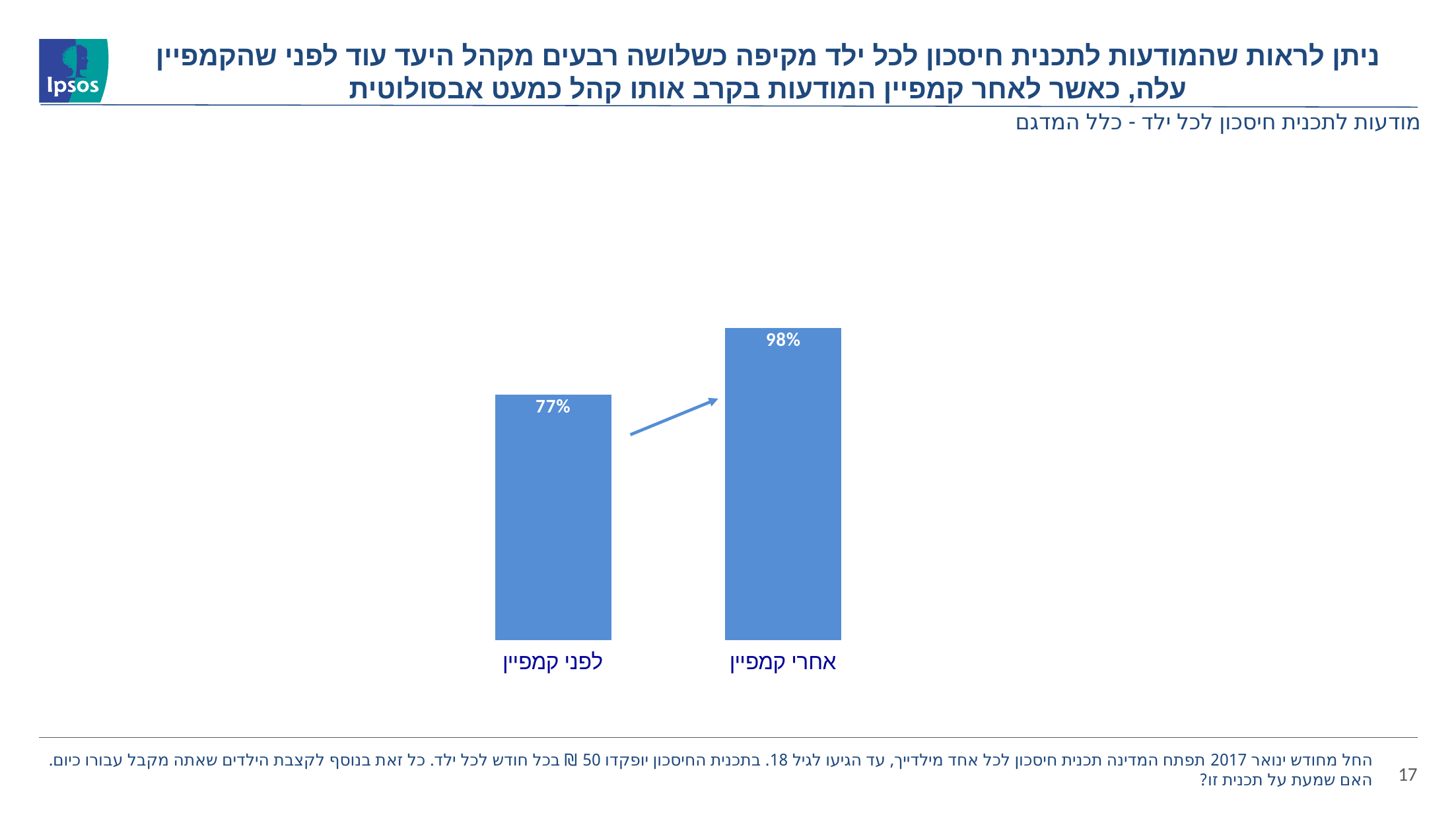
Which is larger, the value for לפני קמפיין or the value for אחרי קמפיין? אחרי קמפיין What is the subtitle shown above the chart? מודעות לתכנית חיסכון לכל ילד - כלל המדגם How many categories are shown in the chart? 2 What is the value for לפני קמפיין? 77% Do the values rise or fall from לפני קמפיין to אחרי קמפיין? Rise What kind of chart is shown on the slide? Bar chart What is the value for אחרי קמפיין? 98% What is the difference between the values for אחרי קמפיין and לפני קמפיין? 21% Which category has the highest value? אחרי קמפיין What colour are the bars in the chart? Blue Which category has the lowest value? לפני קמפיין